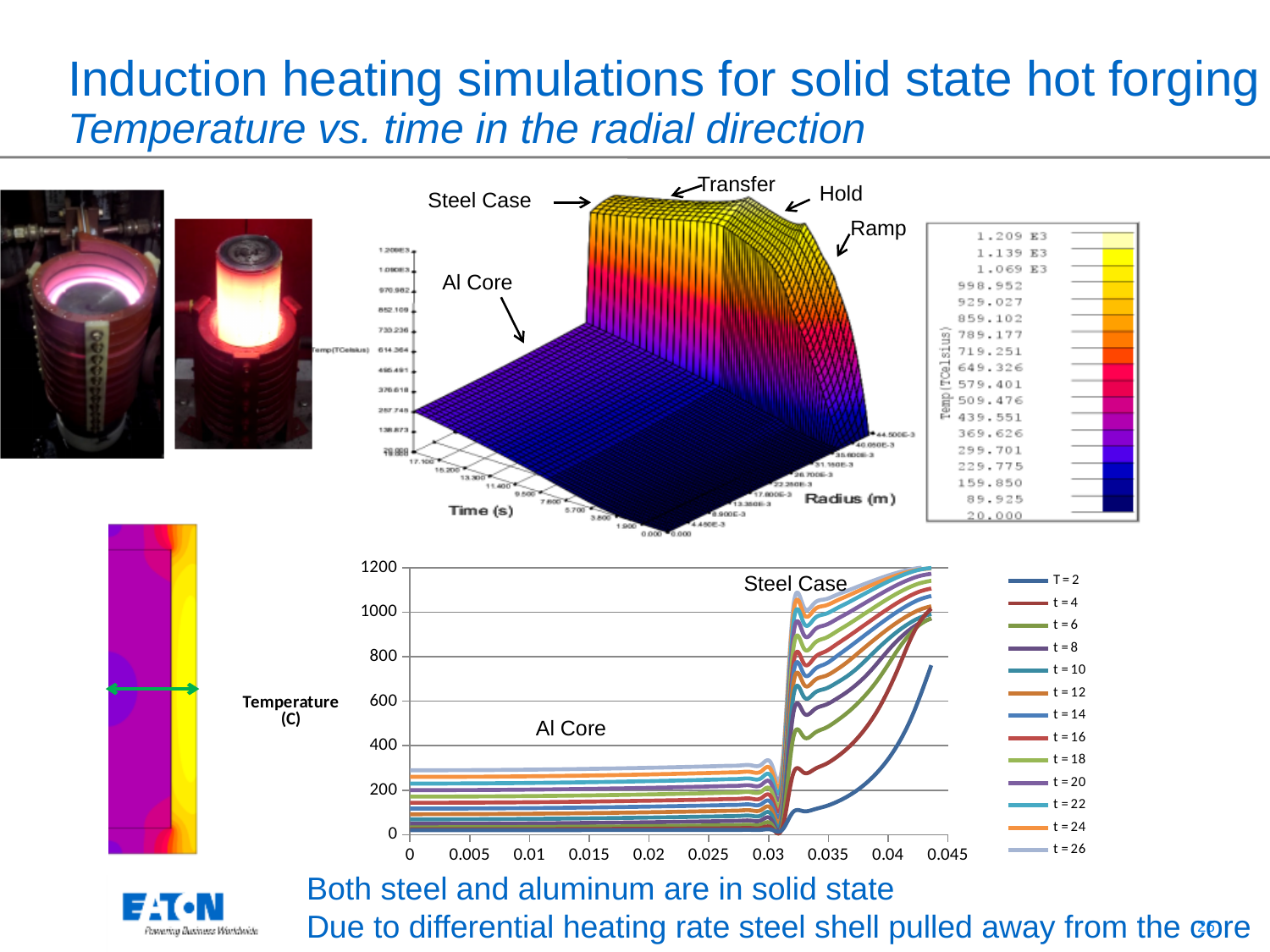
In the bottom line chart, what is the highest value shown on the Temperature (C) axis? 1200 In the bottom line chart, is the value of the T = 2 series at radius 0.02 greater or less than 200? less In the bottom line chart, does the temperature of the t = 26 series rise or fall as the radius increases from 0.03 to 0.04? rise In the bottom line chart, what is the largest value shown on the x axis? 0.045 What kind of chart is the bottom chart with the Temperature (C) axis? line chart In the bottom line chart, is the value of the t = 26 series at radius 0 greater or less than 400? less In the bottom line chart, how many series does the legend list? 13 In the bottom line chart, which series has the lowest temperature at radius 0.01? T = 2 In the bottom line chart, is the value of the t = 26 series at radius 0.04 greater or less than 1000? greater In the bottom line chart, which series has the highest temperature at radius 0? t = 26 In the top 3D surface chart, what is the highest value shown on the Temp(TCelsius) colour scale? 1.209 E3 In the bottom line chart, at radius 0.035, which is larger: the t = 26 series or the T = 2 series? t = 26